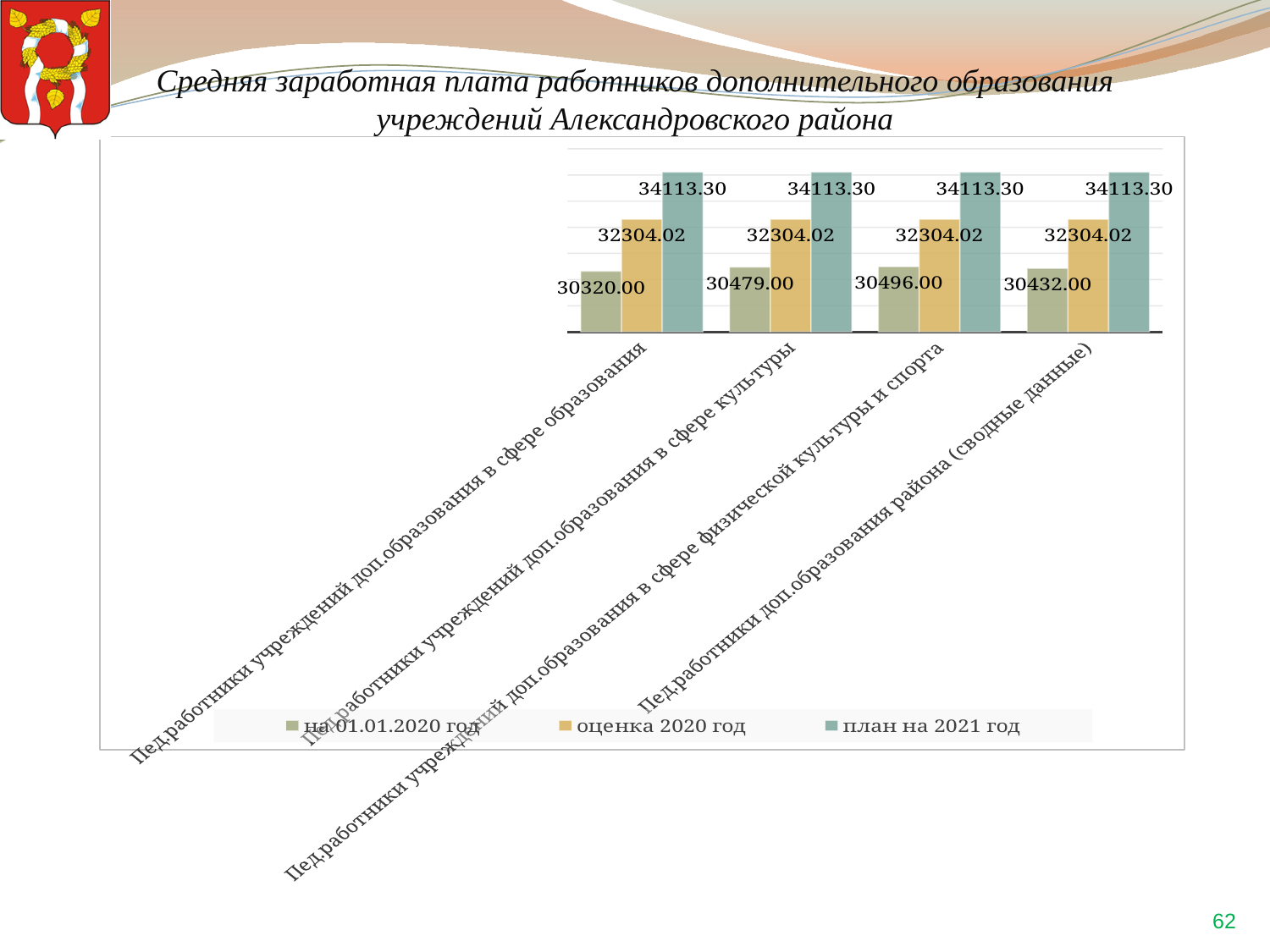
What kind of chart is shown on the slide? Bar chart What is the value for 'на 01.01.2020 год' for Пед.работники учреждений доп.образования в сфере культуры? 30479.00 What is the value for 'на 01.01.2020 год' for Пед.работники доп.образования района (сводные данные)? 30432.00 How many series does the legend list? 3 What is the value for 'план на 2021 год' for Пед.работники учреждений доп.образования в сфере физической культуры и спорта? 34113.30 What is the value for 'на 01.01.2020 год' for Пед.работники учреждений доп.образования в сфере образования? 30320.00 Which category has the lowest value for 'на 01.01.2020 год'? Пед.работники учреждений доп.образования в сфере образования Which is larger for Пед.работники учреждений доп.образования в сфере культуры: 'на 01.01.2020 год' or 'оценка 2020 год'? оценка 2020 год What is the value for 'оценка 2020 год' for Пед.работники доп.образования района (сводные данные)? 32304.02 What is the difference between the 'на 01.01.2020 год' values for Пед.работники учреждений доп.образования в сфере физической культуры и спорта and Пед.работники учреждений доп.образования в сфере образования? 176.00 What is the difference between 'план на 2021 год' and 'оценка 2020 год' for Пед.работники учреждений доп.образования в сфере образования? 1809.28 Which category has the highest value for 'на 01.01.2020 год'? Пед.работники учреждений доп.образования в сфере физической культуры и спорта